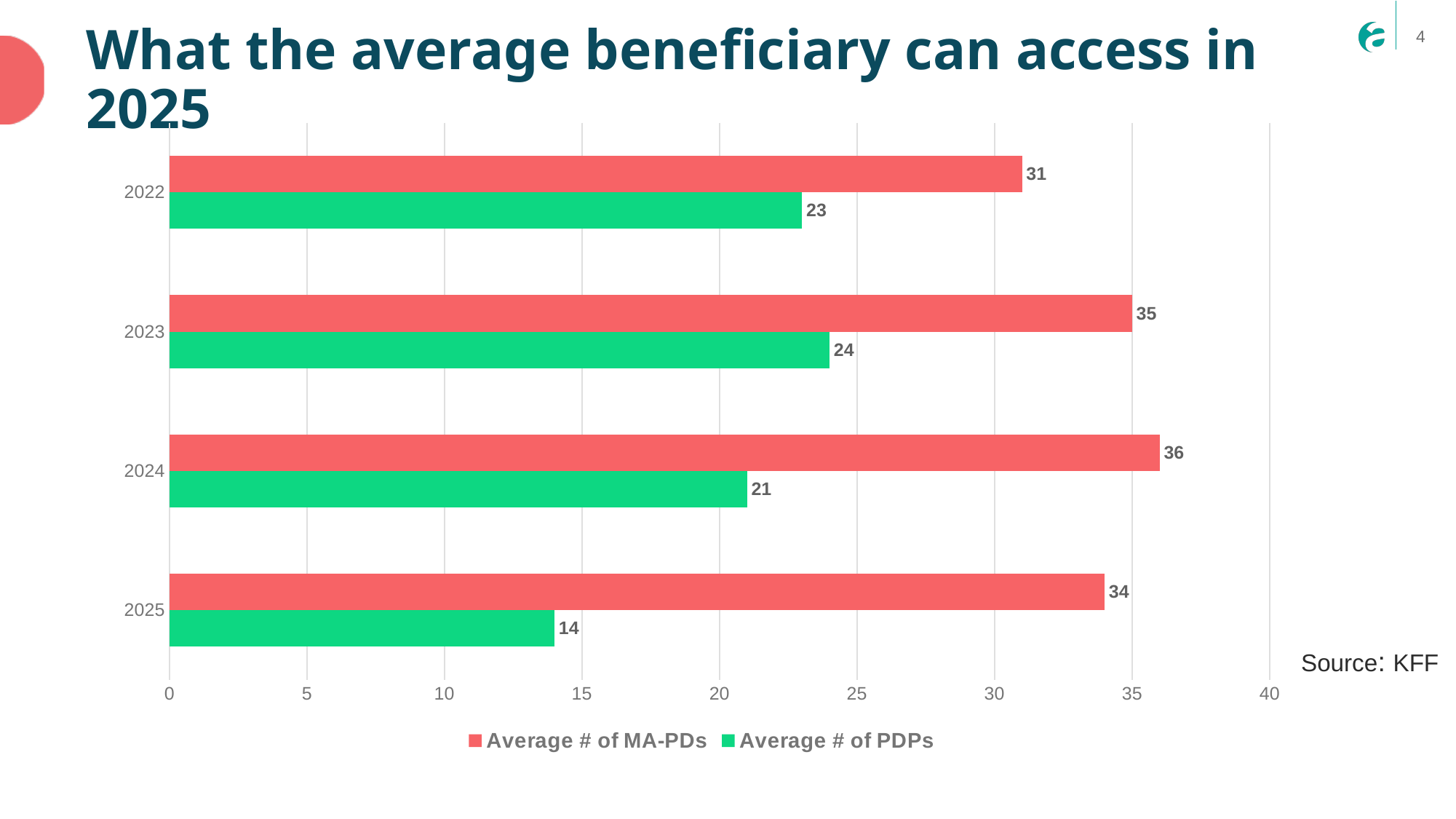
Which year has the lowest Average # of PDPs? 2025 What kind of chart is shown on the slide? Bar chart What is the Average # of PDPs for 2025? 14 How many years are shown on the chart? 4 Which is larger in 2024: the Average # of MA-PDs or the Average # of PDPs? Average # of MA-PDs What is the difference between the Average # of MA-PDs and the Average # of PDPs in 2025? 20 Does the Average # of PDPs rise or fall from 2023 to 2025? Fall What is the Average # of MA-PDs for 2022? 31 What colour represents the Average # of PDPs series? Green How many series does the legend list? 2 Which year has the highest Average # of MA-PDs? 2024 What is the Average # of PDPs for 2023? 24